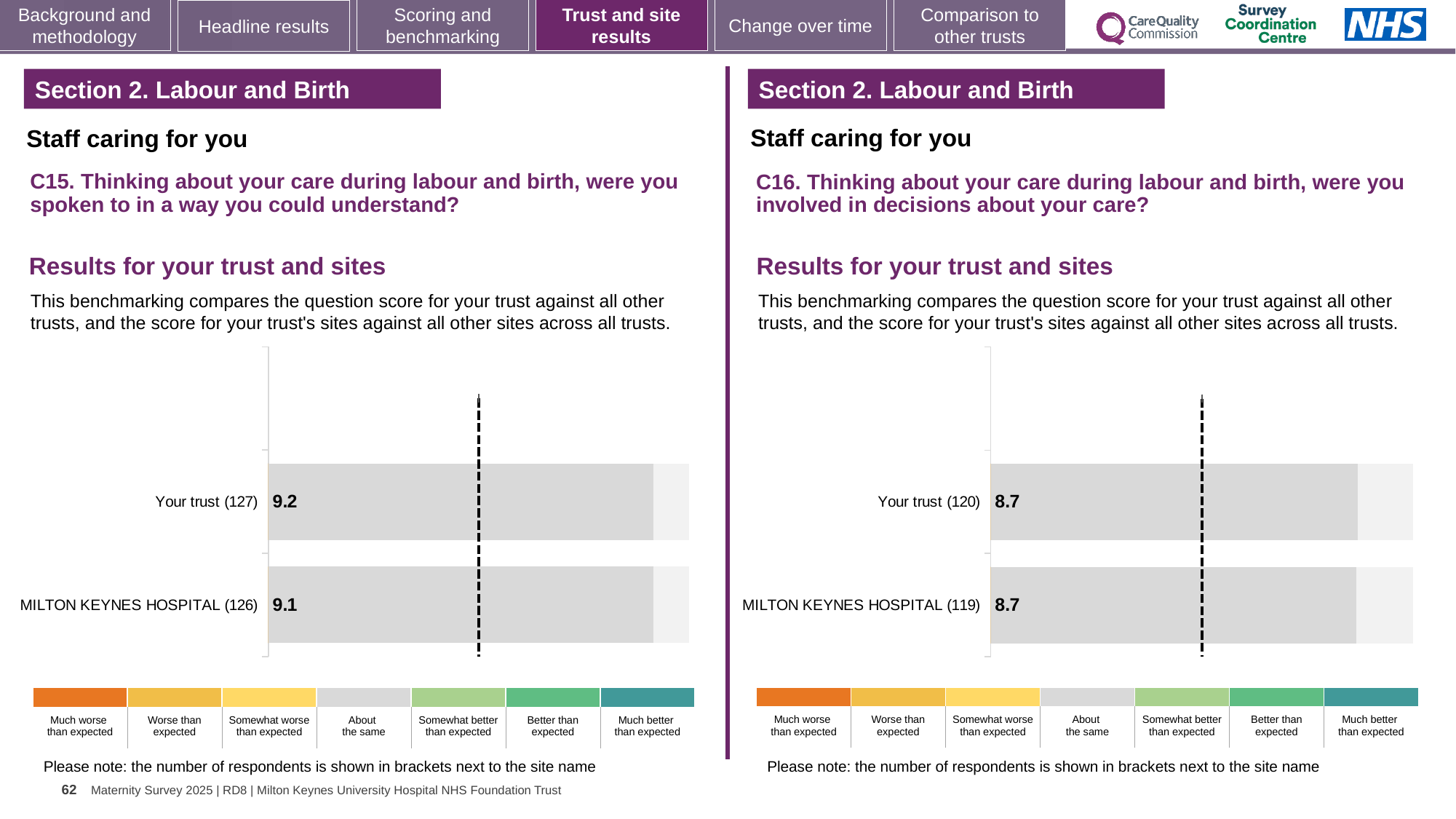
On the left chart (C15), what is the score for Your trust? 9.2 On the right chart (C16), how many respondents are shown in brackets for MILTON KEYNES HOSPITAL? 119 On the left chart (C15), which has the higher score: Your trust or MILTON KEYNES HOSPITAL? Your trust How many bars are plotted on the left chart (C15)? 2 On the left chart (C15), what is the difference between the Your trust score and the MILTON KEYNES HOSPITAL score? 0.1 On the right chart (C16), what is the difference between the Your trust score and the MILTON KEYNES HOSPITAL score? 0 On the left chart (C15), what is the score for MILTON KEYNES HOSPITAL? 9.1 On the left chart (C15), how many respondents are shown in brackets for Your trust? 127 What type of chart is used on the left (C15)? Bar chart On the right chart (C16), what is the score for MILTON KEYNES HOSPITAL? 8.7 On the right chart (C16), what is the score for Your trust? 8.7 How many bars are plotted on the right chart (C16)? 2